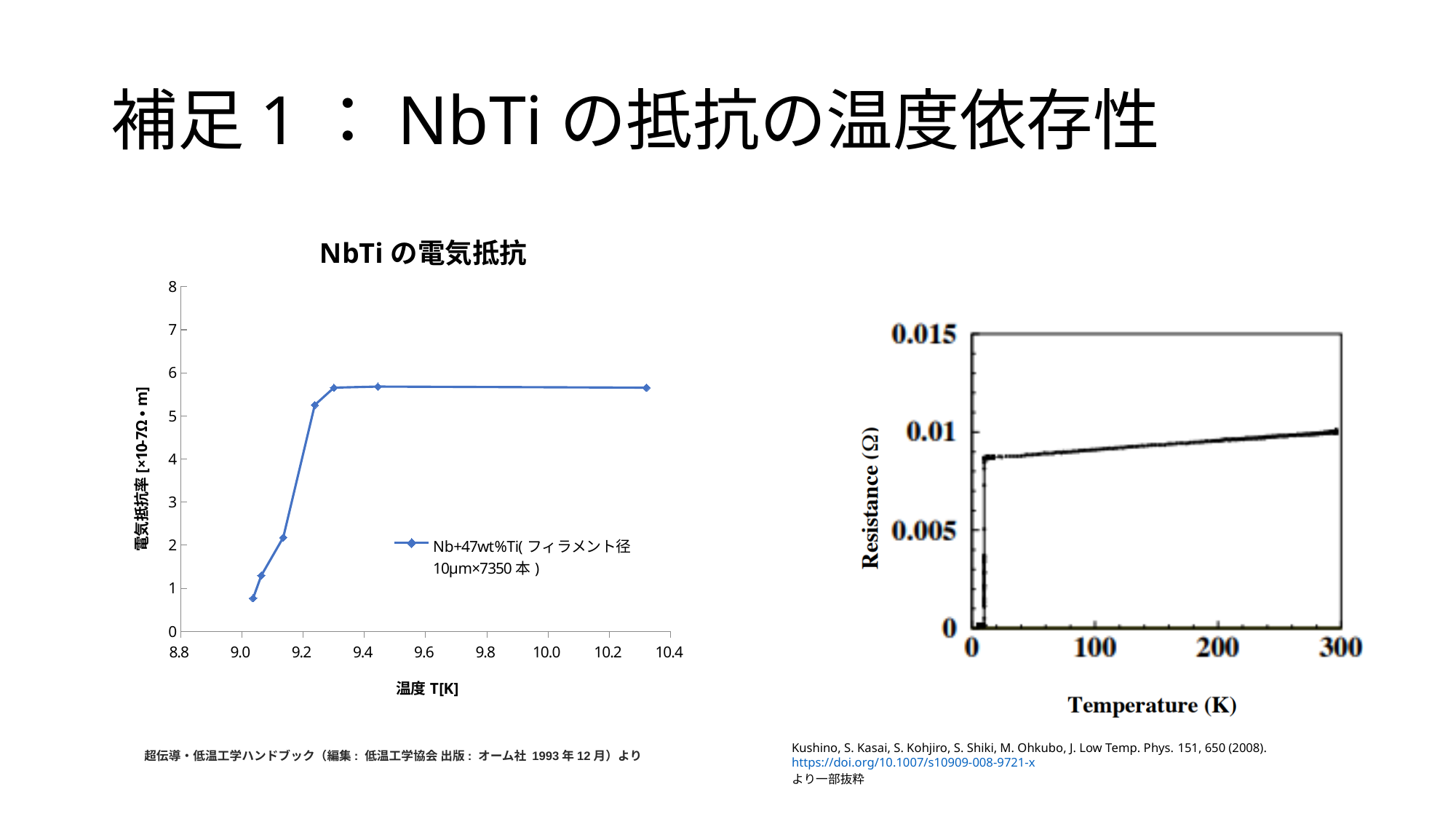
On the left chart titled 'NbTiの電気抵抗', is the value at the highest plotted temperature (about 10.3 K) greater or less than 5? greater What kind of chart is the left chart titled 'NbTiの電気抵抗'? line chart On the left chart titled 'NbTiの電気抵抗', what is the x-axis label? 温度 T[K] On the right chart (Resistance vs Temperature), is the resistance at 100 K greater or less than 0.01 Ω? less On the left chart titled 'NbTiの電気抵抗', do the values rise or fall as temperature increases from 9.0 K to 9.3 K? rise How many series does the legend of the left chart titled 'NbTiの電気抵抗' list? 1 On the right chart (Resistance vs Temperature), does the resistance rise or fall as temperature increases from 100 K to 300 K? rise On the right chart (Resistance vs Temperature), is the resistance at 300 K greater or less than 0.005 Ω? greater How many data points are plotted on the left chart titled 'NbTiの電気抵抗'? 7 On the left chart titled 'NbTiの電気抵抗', what is the legend entry for the plotted series? Nb+47wt%Ti(フィラメント径10μm×7350本)